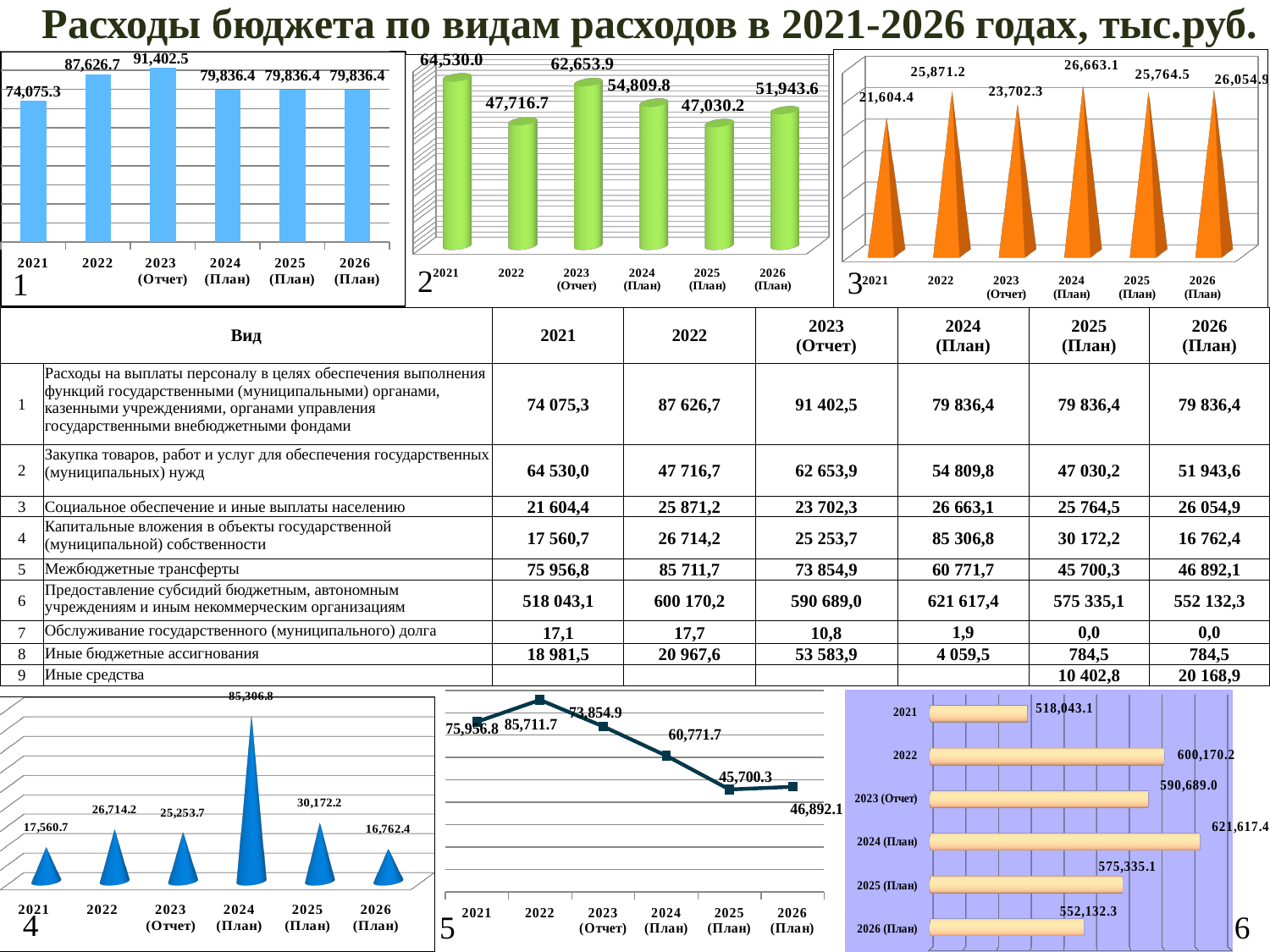
In chart 3 (top-right, orange cones), what is the value for 2024 (План)? 26,663.1 In chart 3 (top-right, orange cones), which year has the lowest value? 2021 In chart 4 (bottom-left, blue cones), what is the difference between the 2024 (План) value and the 2026 (План) value? 68,544.4 In chart 1 (top-left, blue bars), which year has the highest value? 2023 (Отчет) In chart 2 (top-middle, green bars), what is the value for 2025 (План)? 47,030.2 In chart 6 (bottom-right, horizontal bars), how many bars are plotted? 6 In chart 5 (bottom-middle), what kind of chart is shown? Line chart In chart 6 (bottom-right, horizontal bars), which year has the highest value? 2024 (План) In chart 4 (bottom-left, blue cones), what is the value for 2024 (План)? 85,306.8 In chart 5 (bottom-middle, line chart), what is the value for 2025 (План)? 45,700.3 In chart 1 (top-left, blue bars), what is the value for 2021? 74,075.3 In chart 2 (top-middle, green bars), which year has the highest value? 2021